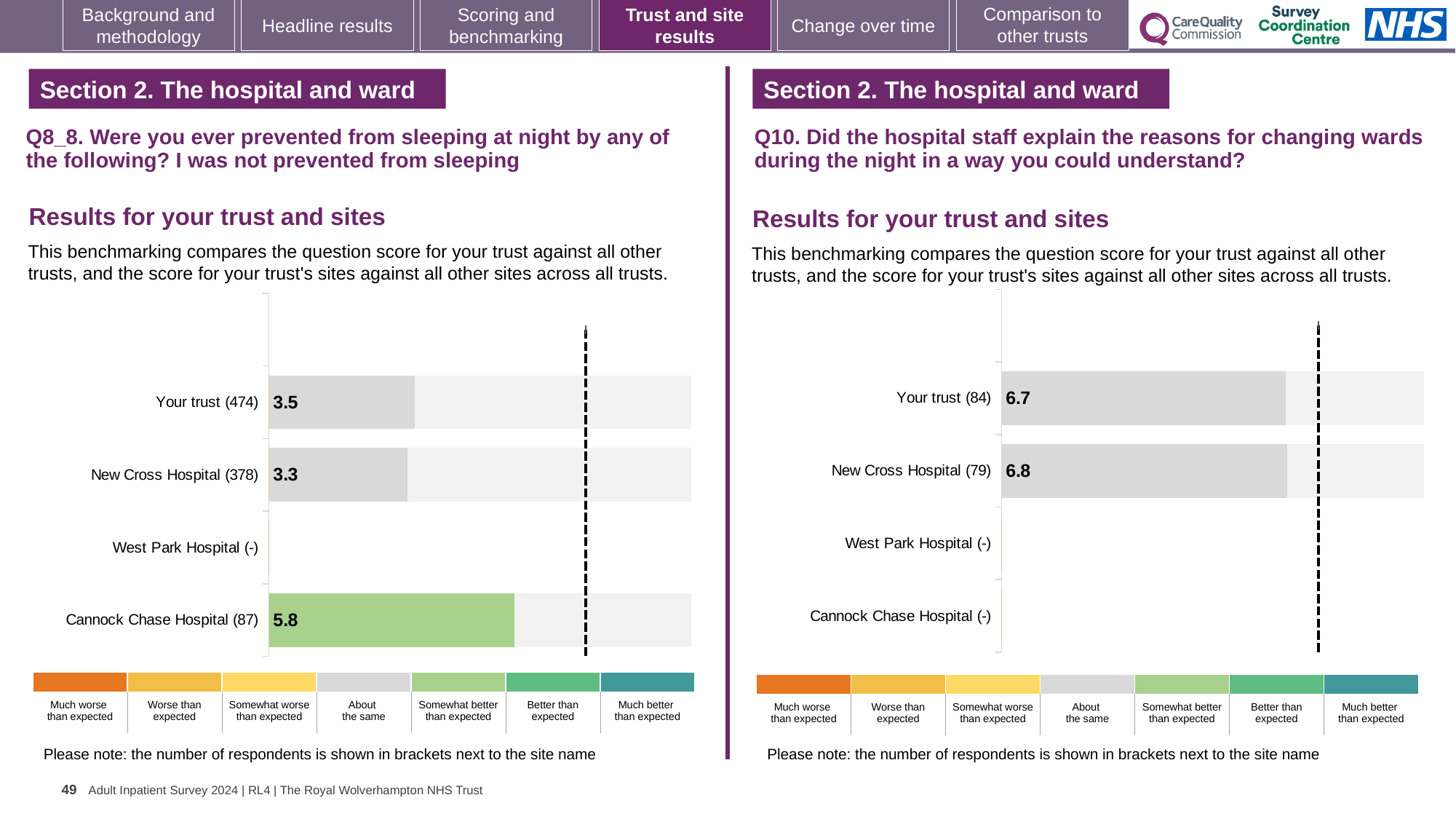
On the Q8_8 chart (left), which is larger: the score for Your trust or the score for New Cross Hospital? Your trust On the Q8_8 chart (left), how many respondents are shown for Cannock Chase Hospital? 87 On the Q10 chart (right), what is the score for New Cross Hospital? 6.8 On the Q8_8 chart (left), which site has the highest score? Cannock Chase Hospital On the Q10 chart (right), how many respondents are shown for Your trust? 84 On the Q10 chart (right), what is the score for Your trust? 6.7 On the Q10 chart (right), what is the difference between the New Cross Hospital score and the Your trust score? 0.1 On the Q8_8 chart (left), what is the score for Cannock Chase Hospital? 5.8 On the Q8_8 chart (left), what is the score for New Cross Hospital? 3.3 On the Q8_8 chart (left), what is the difference between the Cannock Chase Hospital score and the Your trust score? 2.3 On the Q8_8 chart (left), what is the score for Your trust? 3.5 What kind of chart is used on the Q8_8 chart (left)? Bar chart